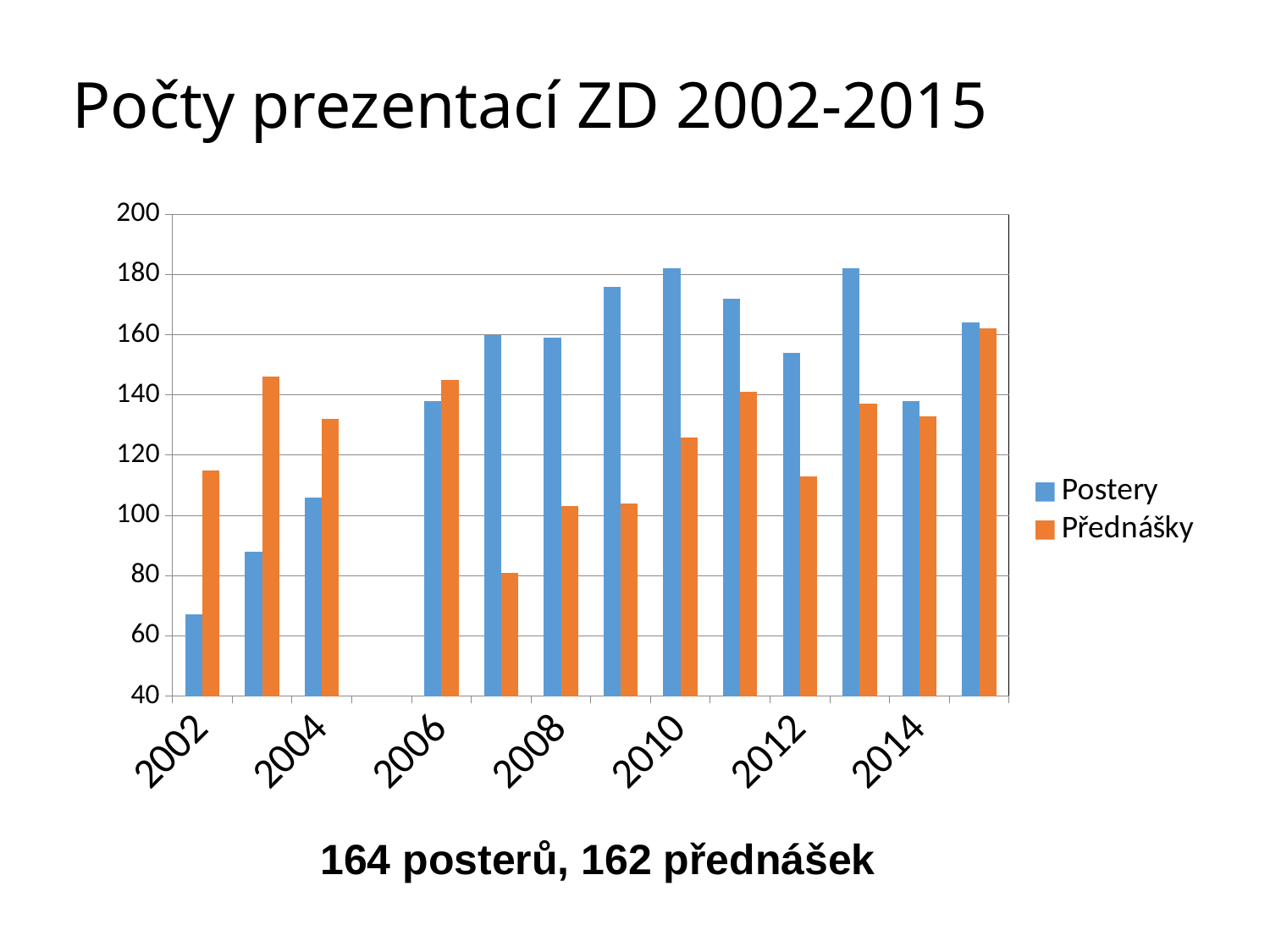
In 2010, which is larger, Postery or Přednášky? Postery Is the value for Přednášky in 2002 greater or less than 100? greater In 2002, which is larger, Postery or Přednášky? Přednášky What kind of chart is shown on the slide? bar chart Which year has the lowest value for Postery? 2002 Is the value for Postery in 2010 greater or less than 160? greater Is the value for Přednášky in 2012 greater or less than 120? less How many series does the legend list? 2 Which series is shown in orange? Přednášky What is the title of the chart? Počty prezentací ZD 2002-2015